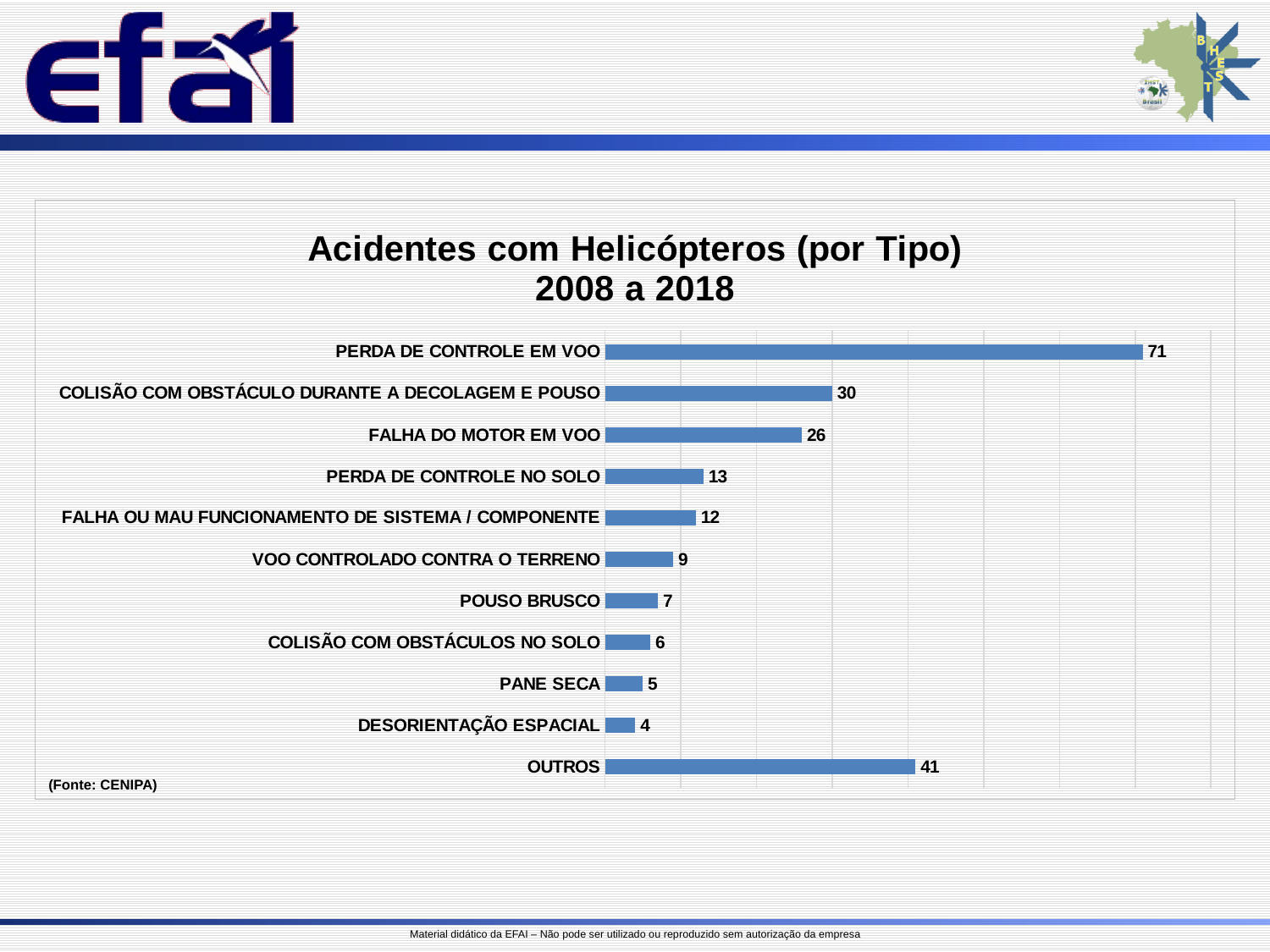
What is the value for OUTROS? 41 What is the value for PANE SECA? 5 What is the difference between the values for PERDA DE CONTROLE EM VOO and OUTROS? 30 Which category has the lowest value? DESORIENTAÇÃO ESPACIAL What kind of chart is shown on the slide? Bar chart Which is larger, the value for PERDA DE CONTROLE NO SOLO or the value for VOO CONTROLADO CONTRA O TERRENO? PERDA DE CONTROLE NO SOLO What is the value for FALHA DO MOTOR EM VOO? 26 What is the difference between the values for COLISÃO COM OBSTÁCULO DURANTE A DECOLAGEM E POUSO and FALHA DO MOTOR EM VOO? 4 What is the title of the chart? Acidentes com Helicópteros (por Tipo) 2008 a 2018 What is the value for PERDA DE CONTROLE EM VOO? 71 How many categories are shown in the chart? 11 Which category has the highest value? PERDA DE CONTROLE EM VOO